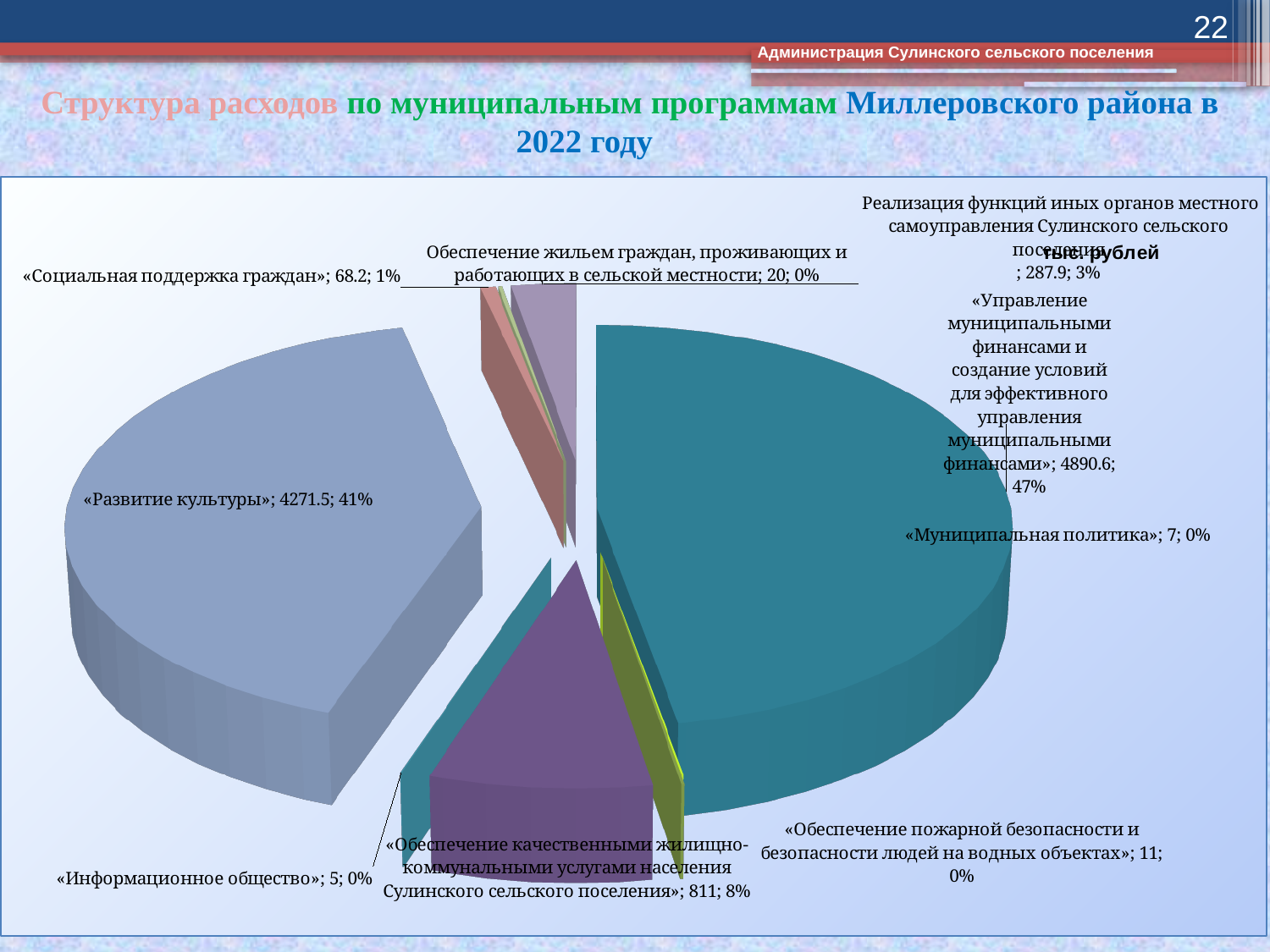
In what units are the values in the chart given? тыс. рублей What share of the pie does «Реализация функций иных органов местного самоуправления Сулинского сельского поселения» represent? 3% What is the value for «Социальная поддержка граждан»? 68.2 What share of the pie does «Развитие культуры» represent? 41% What kind of chart is shown on the slide? pie chart What is the value for «Развитие культуры»? 4271.5 What is the value for «Обеспечение качественными жилищно-коммунальными услугами населения Сулинского сельского поселения»? 811 Which program has the largest share of the pie? «Управление муниципальными финансами и создание условий для эффективного управления муниципальными финансами» How many slices does the pie chart have? 9 Which program has the smallest value in the pie chart? «Информационное общество» What is the difference between the values for «Управление муниципальными финансами...» (4890.6) and «Развитие культуры» (4271.5)? 619.1 Which is larger: the value for «Муниципальная политика» or the value for «Обеспечение пожарной безопасности и безопасности людей на водных объектах»? «Обеспечение пожарной безопасности и безопасности людей на водных объектах»